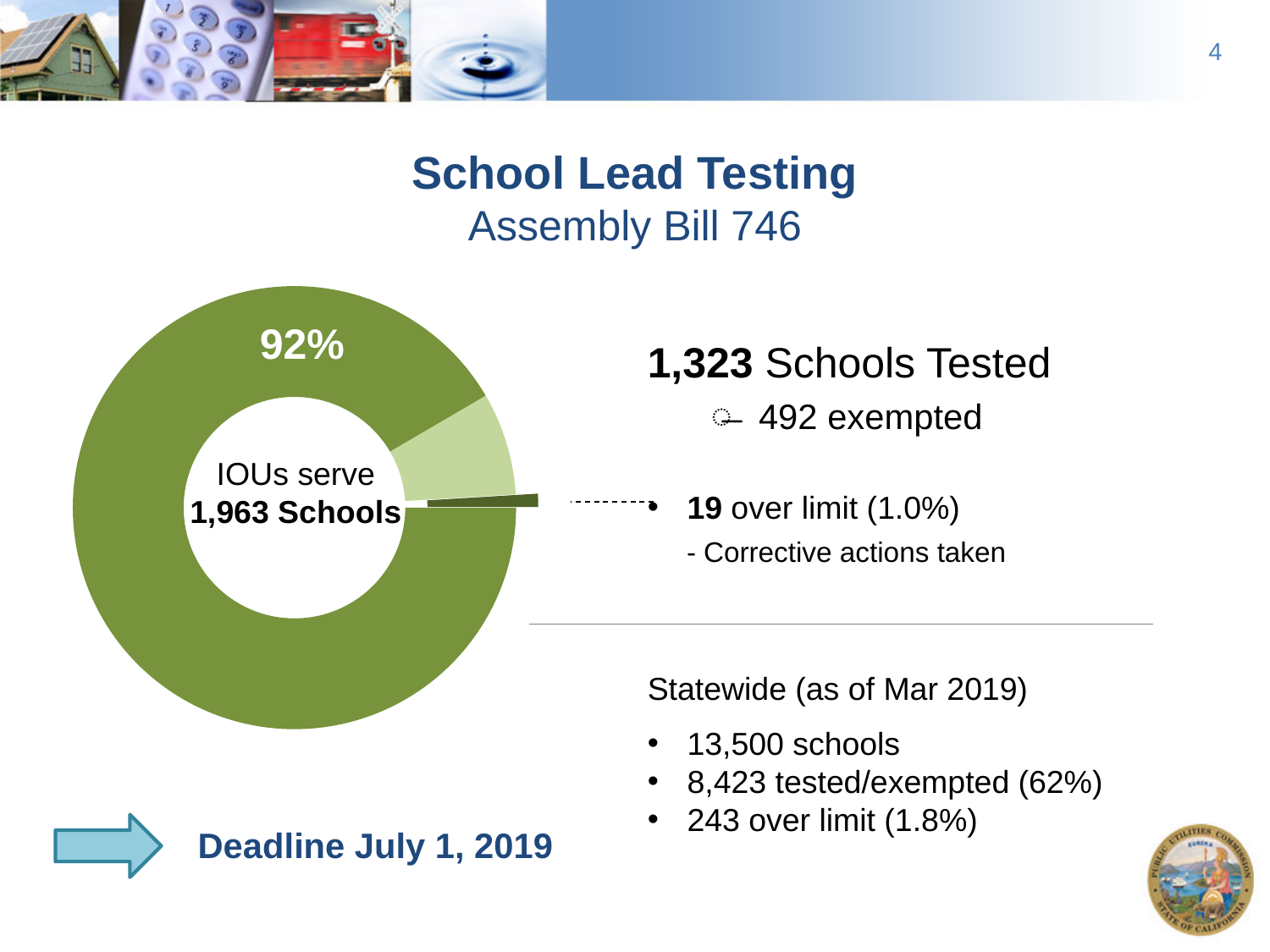
What percentage is printed on the largest slice of the donut chart? 92% What share of the donut chart does the slice labelled 92% represent? 92% What does the dotted line from the thin dark green slice point to? 19 over limit (1.0%) What text is printed in the centre of the donut chart? IOUs serve 1,963 Schools How many slices does the donut chart have? 3 Which is larger: the light green slice or the thin dark green slice? The light green slice Is the light green slice of the donut chart greater or less than 25% of the whole? less Is the largest slice of the donut chart greater or less than 50% of the whole? greater Which slice of the donut chart is the smallest? The thin dark green slice (19 over limit) What kind of chart is shown on the slide? Pie chart (donut)